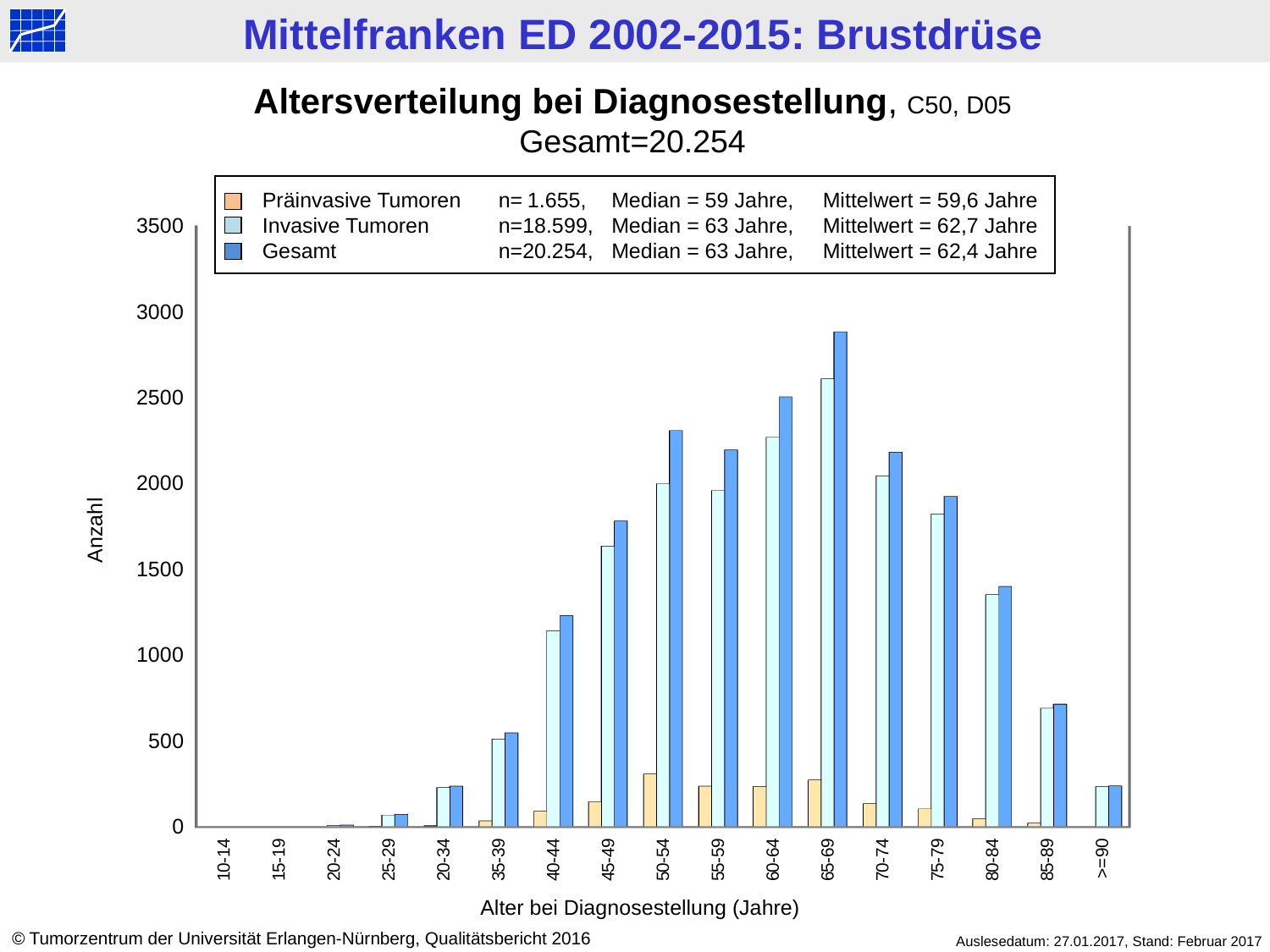
According to the legend, what is the median age for Invasive Tumoren? 63 Jahre Which age group has the highest value for Gesamt? 65-69 According to the legend, what is n for Präinvasive Tumoren? 1.655 Is the Gesamt value for the 65-69 age group greater or less than 2500? greater Is the Gesamt value for the 40-44 age group greater or less than 1000? greater Which is larger for Invasive Tumoren: the value for 55-59 or the value for 80-84? 55-59 How many age groups are shown on the x axis? 17 Do the Gesamt values rise or fall from the 65-69 age group to the >=90 age group? fall How many series does the legend list? 3 Which is larger for Gesamt: the value for 60-64 or the value for 70-74? 60-64 Is the Gesamt value for the 85-89 age group greater or less than 1000? less What kind of chart is shown on the slide? bar chart